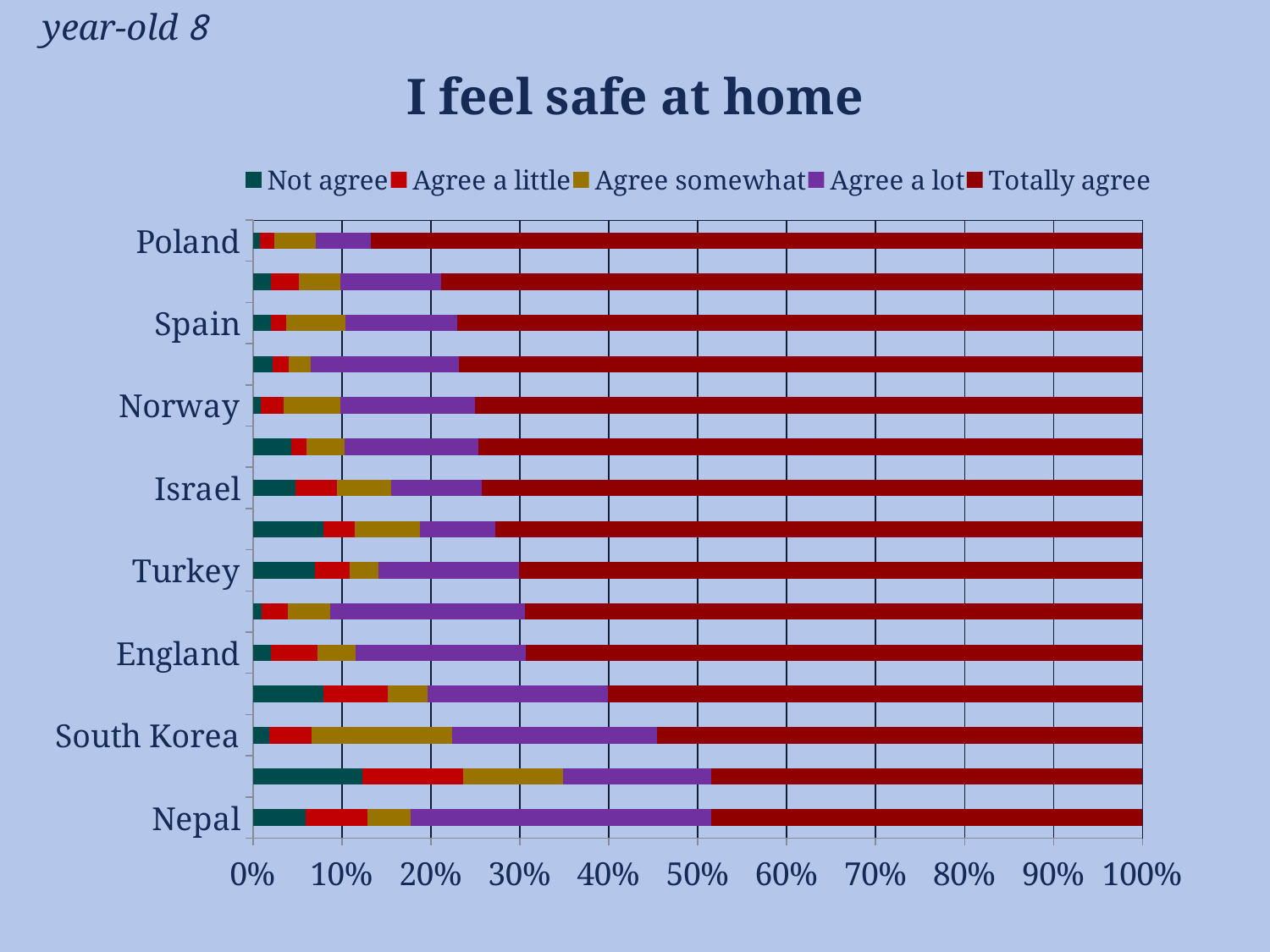
Which has the larger 'Totally agree' share, Poland or Nepal? Poland Is the 'Totally agree' share for South Korea greater or less than 60%? less What is the title of the chart? I feel safe at home What kind of chart is shown on the slide? Stacked bar chart Is the 'Totally agree' share for Poland greater or less than 80%? greater Which has the larger 'Not agree' share, Nepal or Poland? Nepal Which legend entry is shown in dark red? Totally agree Among the labelled countries, which has the highest 'Totally agree' share? Poland Does the 'Totally agree' share generally increase or decrease going from the top bar to the bottom bar? decrease Is the 'Not agree' share for Nepal greater or less than 10%? less How many series does the legend list? 5